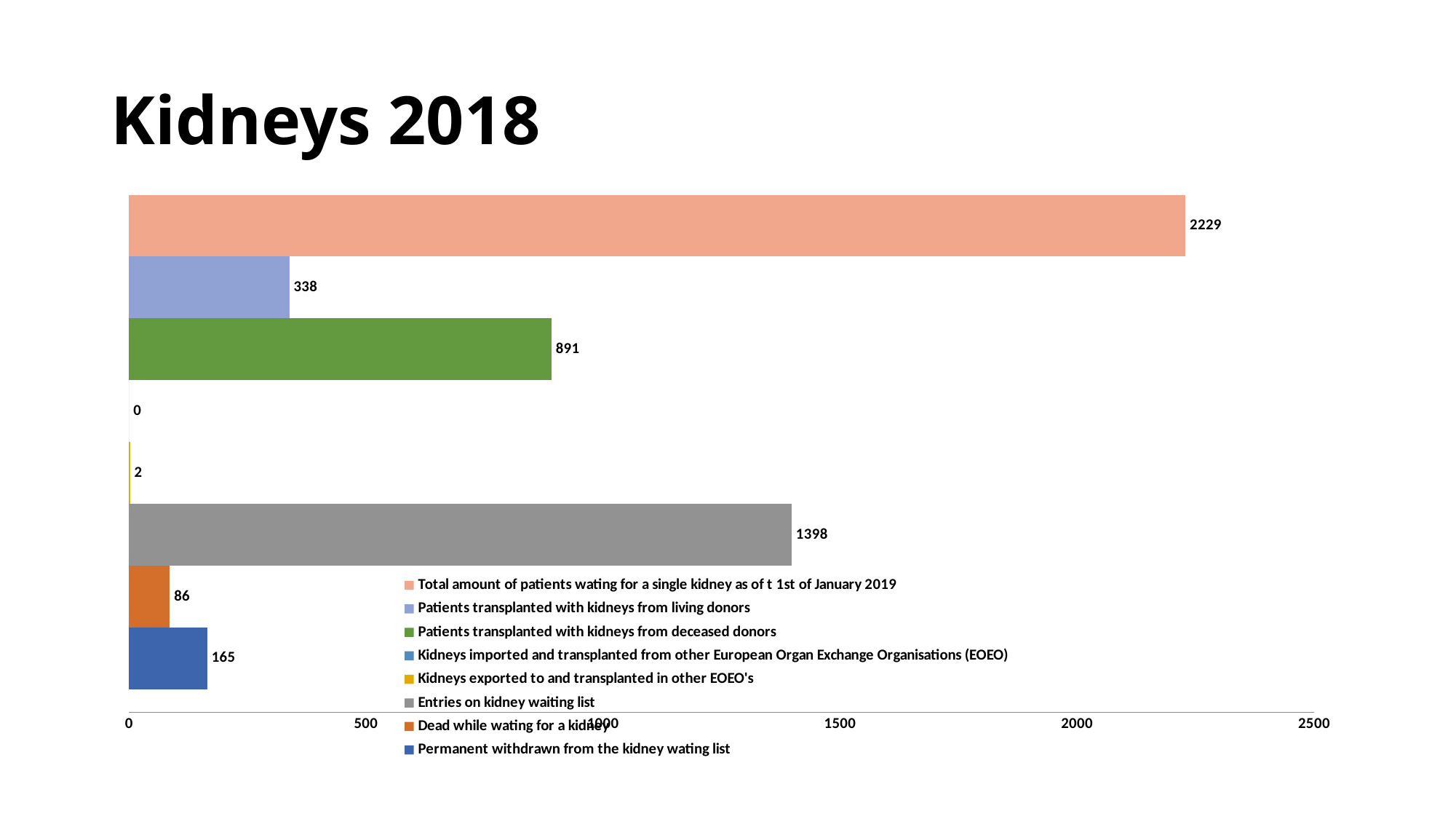
What is the value for Patients transplanted with kidneys from living donors? 338 What is the value for Dead while wating for a kidney? 86 Which series has the lowest value? Kidneys imported and transplanted from other European Organ Exchange Organisations (EOEO) What is the value for Patients transplanted with kidneys from deceased donors? 891 Which series has the highest value? Total amount of patients wating for a single kidney as of t 1st of January 2019 What kind of chart is shown on the slide? Bar chart What is the value for Permanent withdrawn from the kidney wating list? 165 What is the value for Entries on kidney waiting list? 1398 What is the title of the slide? Kidneys 2018 Which is larger: Entries on kidney waiting list or Patients transplanted with kidneys from deceased donors? Entries on kidney waiting list How many series does the legend list? 8 What is the difference between Patients transplanted with kidneys from deceased donors and Patients transplanted with kidneys from living donors? 553